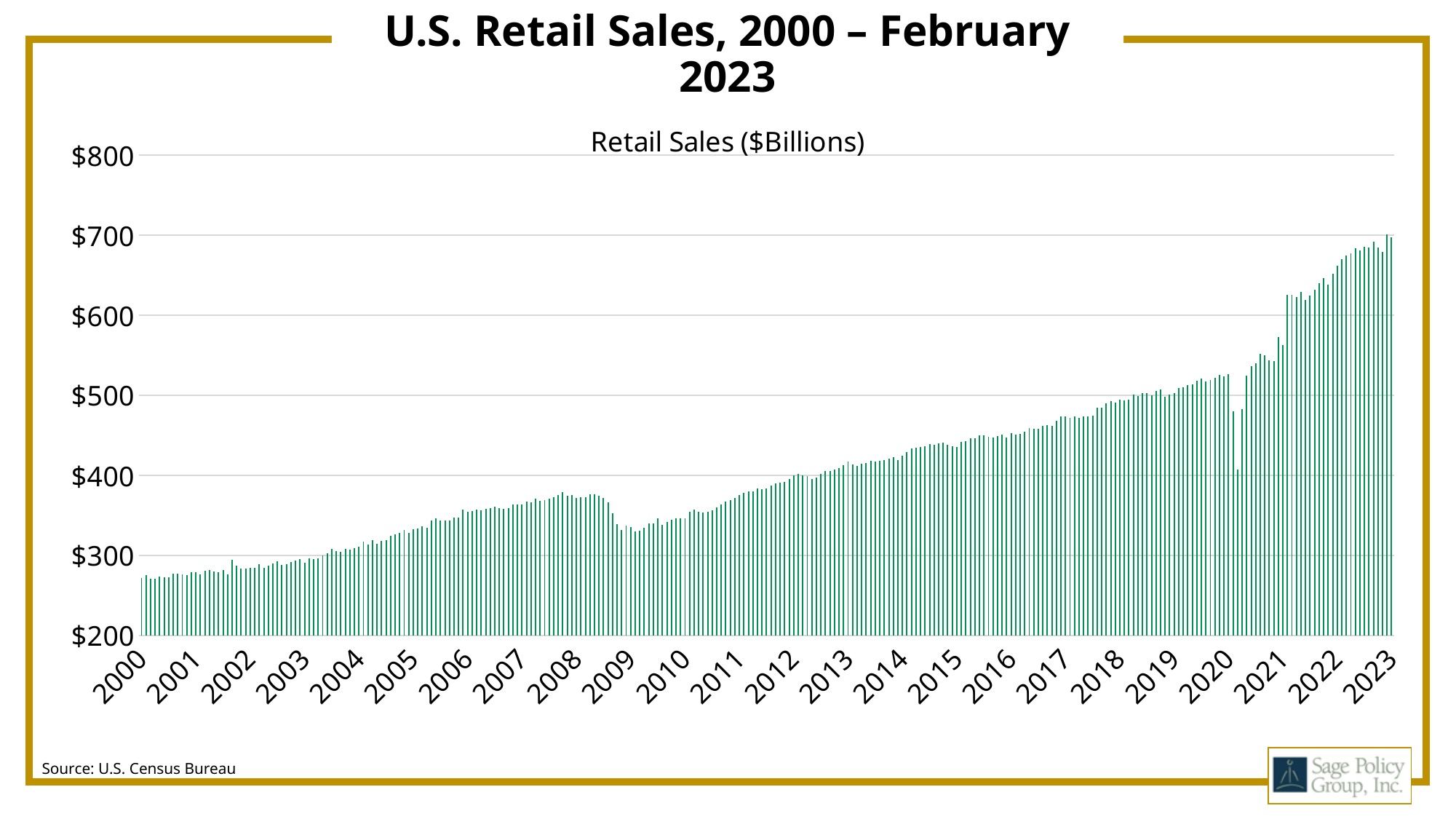
What unit are retail sales measured in, according to the chart? $Billions Is the value for retail sales at the start of 2010 greater or less than $400? less How many year labels are shown on the x axis? 24 What kind of chart is shown on the slide? bar chart In which labeled year do retail sales reach their highest level? 2023 Is the value for retail sales at the start of 2000 greater or less than $300? less What is the title of the chart? Retail Sales ($Billions) Is the value for retail sales at the start of 2023 greater or less than $600? greater Which is larger, retail sales at the start of 2008 or at the start of 2009? 2008 In which labeled year are retail sales at their lowest level? 2000 Overall, do retail sales rise or fall from 2000 to 2023? rise